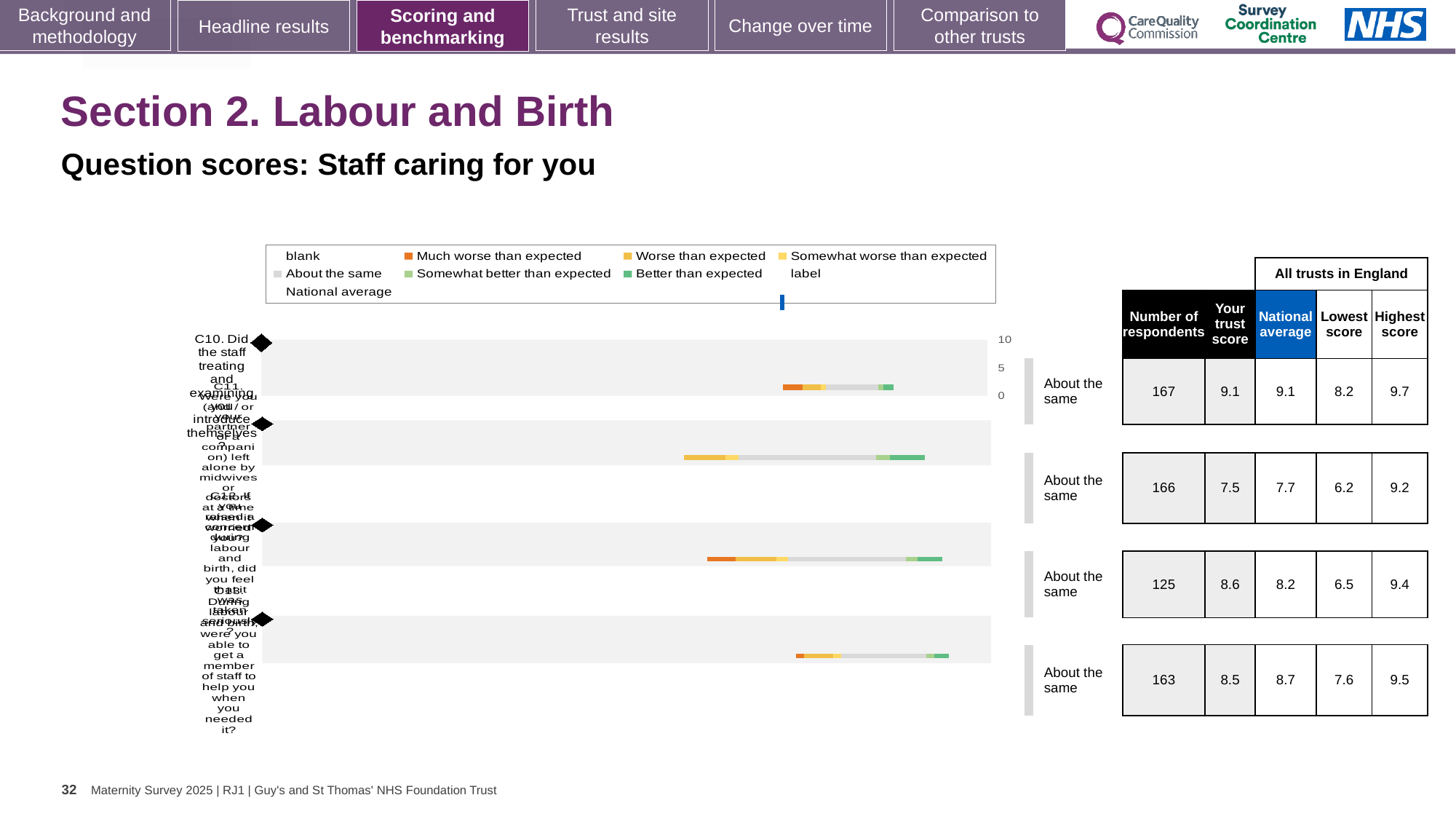
In the table beside the chart, which row has the highest 'Your trust score'? the first row (9.1) In the table beside the chart, what is the number of respondents for the first (top) row? 167 In the table beside the chart, for the third row, which is larger: the trust score or the national average? the trust score (8.6) How many question rows (bars) are plotted in the chart? 4 In the table beside the chart, what is the national average for the fourth (bottom) row? 8.7 In the chart legend, what colour represents 'Much worse than expected'? orange In the table beside the chart, what is the 'Your trust score' for the second row? 7.5 In the table beside the chart, what is the difference between the highest score and the lowest score for the first row? 1.5 In the table beside the chart, which row has the lowest number of respondents? the third row (125) What kind of chart is shown on the slide? bar chart What benchmark category label is shown next to each of the four bars? About the same In the chart legend, what colour represents 'Better than expected'? green